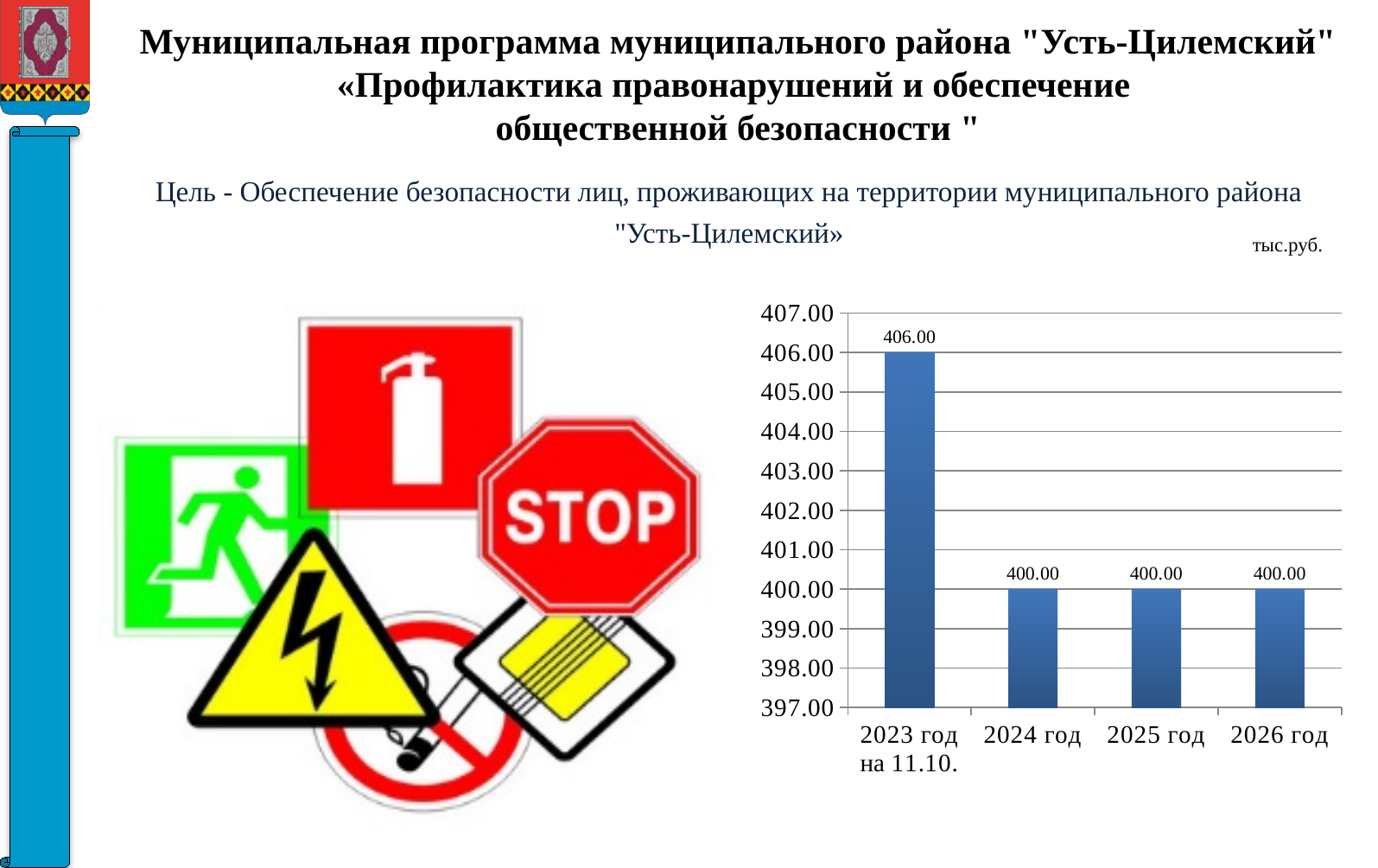
Do the values rise or fall from 2023 год на 11.10. to 2024 год? fall Which is larger, the value for 2023 год на 11.10. or the value for 2025 год? 2023 год на 11.10. What is the value for 2024 год? 400.00 Is the value for 2023 год на 11.10. greater or less than 405.00? greater What unit is indicated above the chart? тыс.руб. What kind of chart is shown on the slide? bar chart How many categories are shown on the x axis? 4 What is the value for 2023 год на 11.10.? 406.00 What is the difference between the values for 2023 год на 11.10. and 2024 год? 6.00 Which category has the highest value? 2023 год на 11.10. Is the value for 2025 год greater or less than 403.00? less What is the value for 2026 год? 400.00